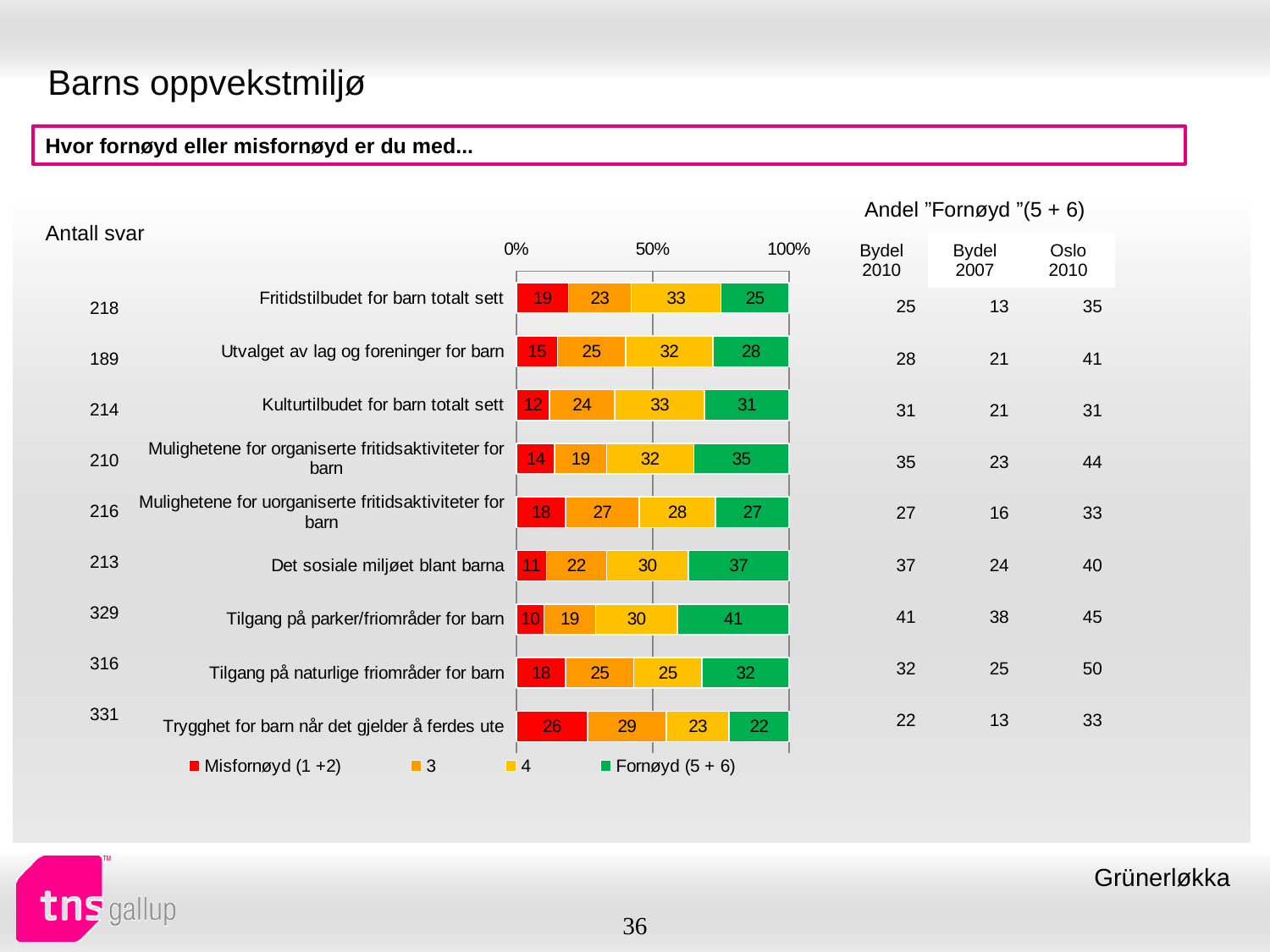
What is the name of the first series in the chart legend? Misfornøyd (1 +2) What is the value of series '3' for 'Mulighetene for uorganiserte fritidsaktiviteter for barn'? 27 How many categories are plotted in the chart? 9 How many series does the chart legend list? 4 What is the 'Misfornøyd (1 +2)' value for 'Trygghet for barn når det gjelder å ferdes ute'? 26 What type of chart is shown on the slide? Stacked bar chart What is the total of the stacked bar for 'Fritidstilbudet for barn totalt sett'? 100 Which category has the highest 'Fornøyd (5 + 6)' value? Tilgang på parker/friområder for barn What is the 'Fornøyd (5 + 6)' value for 'Tilgang på parker/friområder for barn'? 41 What is the difference between the 'Fornøyd (5 + 6)' values for 'Tilgang på parker/friområder for barn' and 'Trygghet for barn når det gjelder å ferdes ute'? 19 Which category has the lowest 'Misfornøyd (1 +2)' value? Tilgang på parker/friområder for barn Which is larger: the 'Fornøyd (5 + 6)' value for 'Det sosiale miljøet blant barna' or for 'Kulturtilbudet for barn totalt sett'? Det sosiale miljøet blant barna